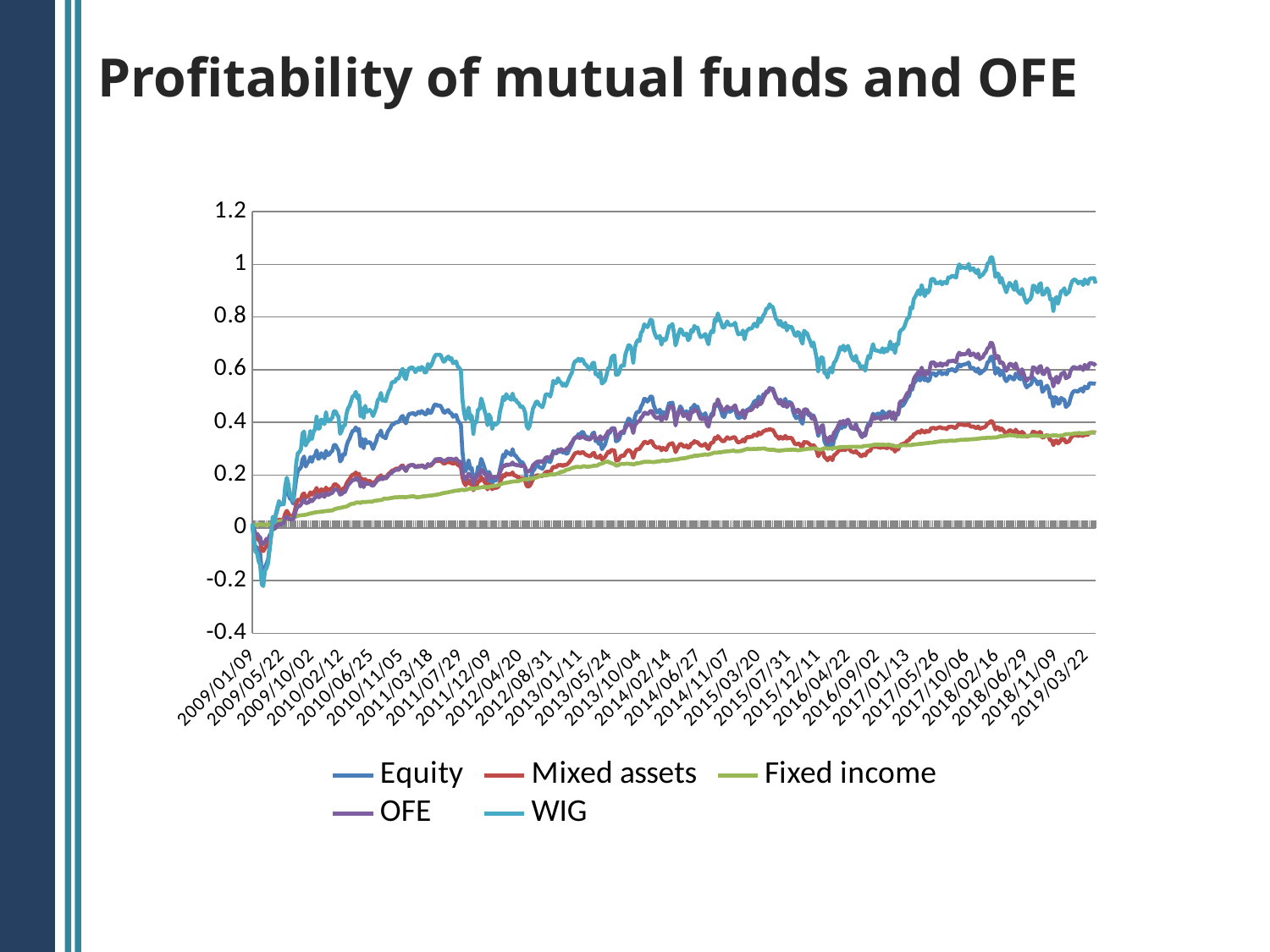
Is the value of Equity at the end of the period (2019/03/22) greater or less than 0.4? greater What is the first date label on the x axis? 2009/01/09 Does the Fixed income series generally rise or fall over the period shown? Rise How many series does the legend list? 5 Is the value of Fixed income at the end of the period (2019/03/22) greater or less than 0.4? less Which series reaches the highest value on the chart? WIG What kind of chart is shown on the slide? Line chart At the end of the period, which is larger: WIG or Fixed income? WIG At the end of the period, which is larger: Equity or Mixed assets? Equity Which series falls to the lowest value on the chart, in early 2009? WIG What is the title of the chart on the slide? Profitability of mutual funds and OFE Is the value of WIG at the end of the period (2019/03/22) greater or less than 0.8? greater